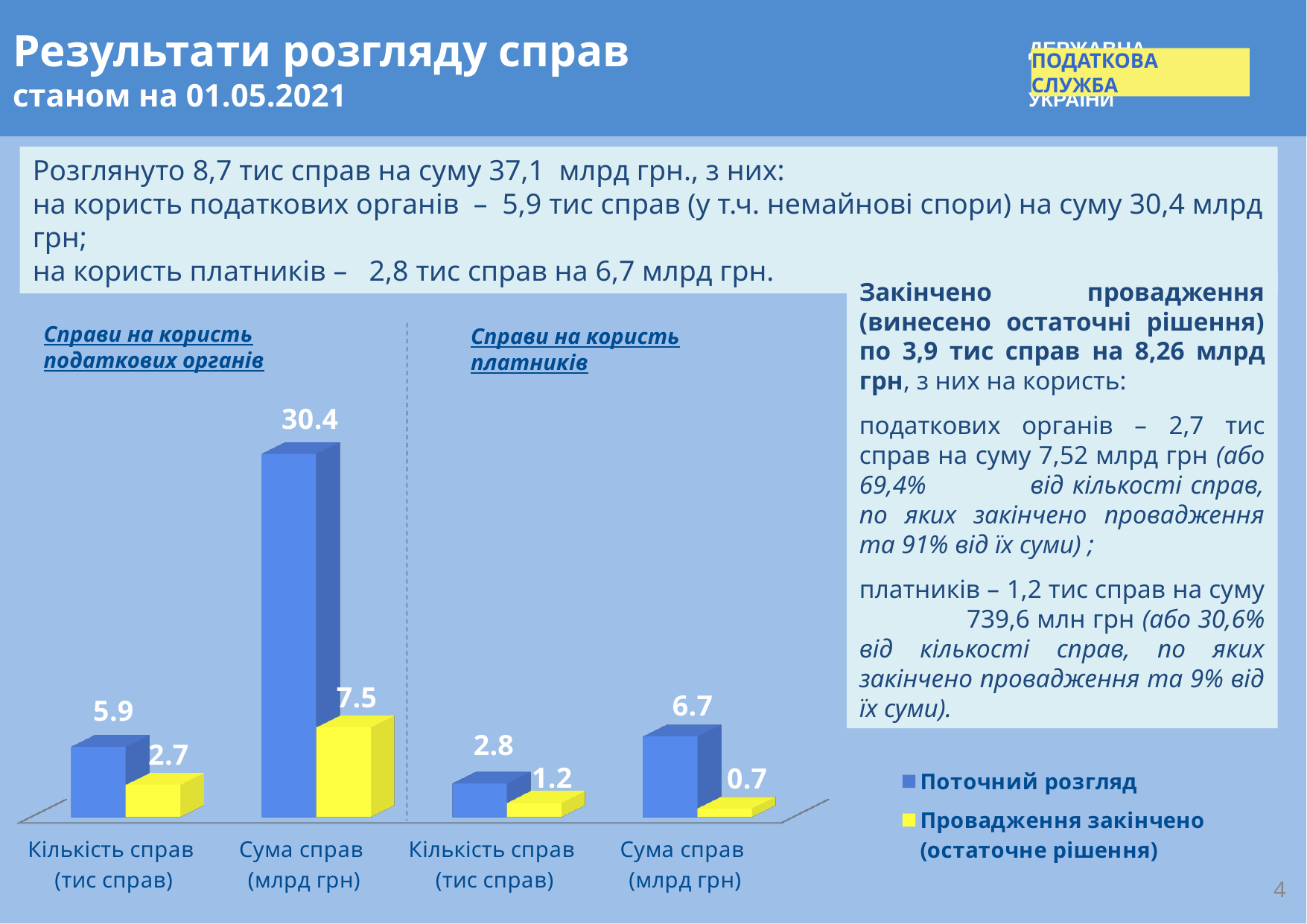
What is the value of "Провадження закінчено (остаточне рішення)" for "Кількість справ (тис справ)" in the "Справи на користь податкових органів" group? 2.7 What is the value of "Поточний розгляд" for "Кількість справ (тис справ)" in the "Справи на користь платників" group? 2.8 What is the difference between "Поточний розгляд" and "Провадження закінчено (остаточне рішення)" for "Сума справ (млрд грн)" in the "Справи на користь податкових органів" group? 22.9 How many series does the chart legend list? 2 How many categories are shown along the x axis of the chart? 4 What colour are the "Провадження закінчено (остаточне рішення)" bars in the chart? yellow What is the value of "Провадження закінчено (остаточне рішення)" for "Сума справ (млрд грн)" in the "Справи на користь платників" group? 0.7 Which bar in the chart has the lowest value? Провадження закінчено (остаточне рішення), Сума справ (млрд грн), Справи на користь платників Which bar in the chart has the highest value? Поточний розгляд, Сума справ (млрд грн), Справи на користь податкових органів Which is larger: "Поточний розгляд" for "Сума справ (млрд грн)" in the "Справи на користь платників" group, or "Провадження закінчено (остаточне рішення)" for "Сума справ (млрд грн)" in the "Справи на користь податкових органів" group? Провадження закінчено (остаточне рішення) for Справи на користь податкових органів (7.5) What is the value of "Поточний розгляд" for "Сума справ (млрд грн)" in the "Справи на користь податкових органів" group? 30.4 What kind of chart is shown on the slide? bar chart